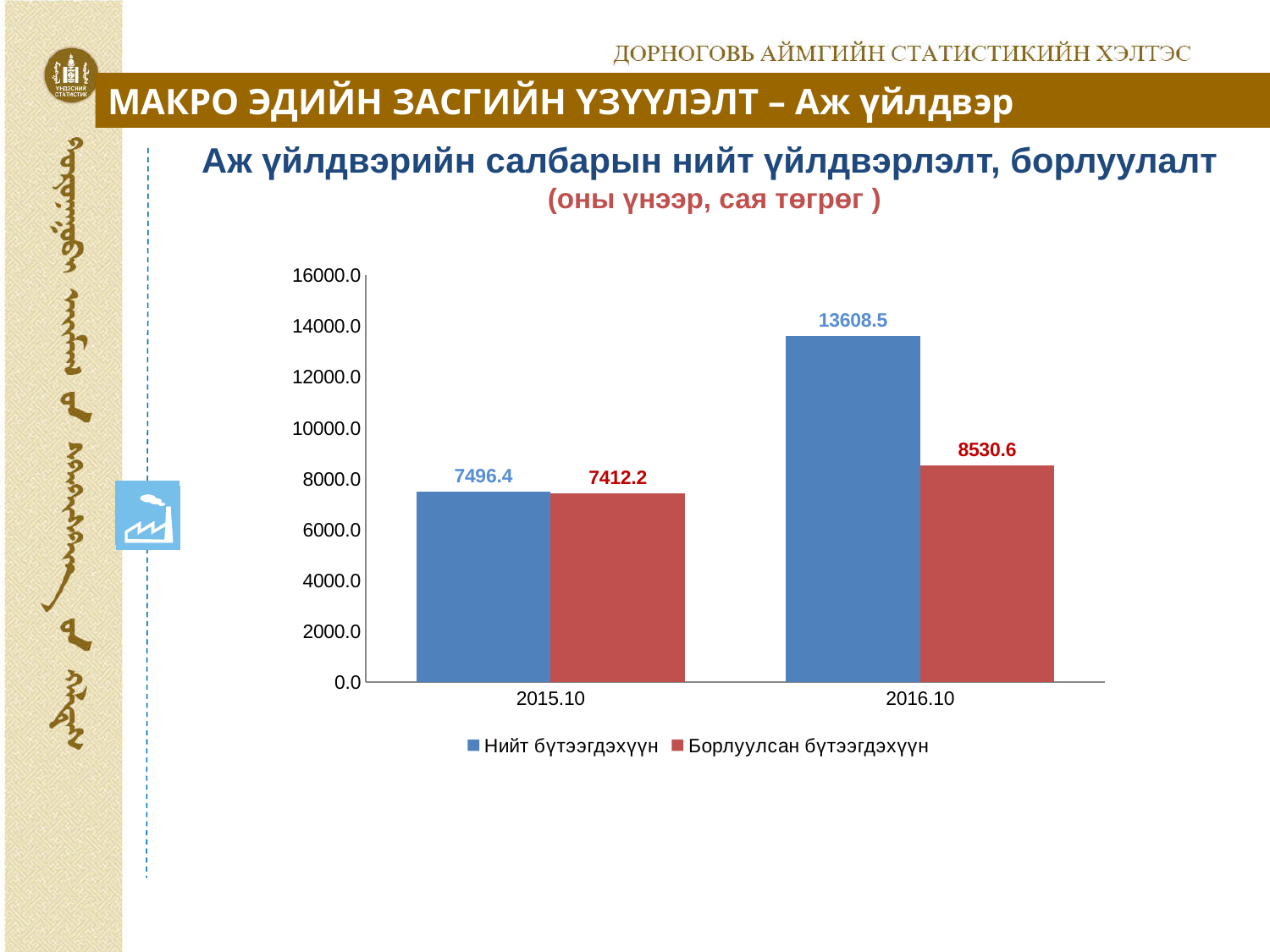
What is the value of Борлуулсан бүтээгдэхүүн for 2015.10? 7412.2 How many periods are shown on the x axis? 2 What is the difference between Нийт бүтээгдэхүүн and Борлуулсан бүтээгдэхүүн in 2016.10? 5077.9 How many series does the legend list? 2 What is the value of Нийт бүтээгдэхүүн for 2015.10? 7496.4 What is the value of Нийт бүтээгдэхүүн for 2016.10? 13608.5 Which period has the lowest value for Борлуулсан бүтээгдэхүүн? 2015.10 Which is larger in 2016.10: Нийт бүтээгдэхүүн or Борлуулсан бүтээгдэхүүн? Нийт бүтээгдэхүүн Is the value of Нийт бүтээгдэхүүн for 2016.10 greater or less than 12000.0? greater What kind of chart is shown on the slide? Bar chart Which period has the highest value for Нийт бүтээгдэхүүн? 2016.10 What is the value of Борлуулсан бүтээгдэхүүн for 2016.10? 8530.6